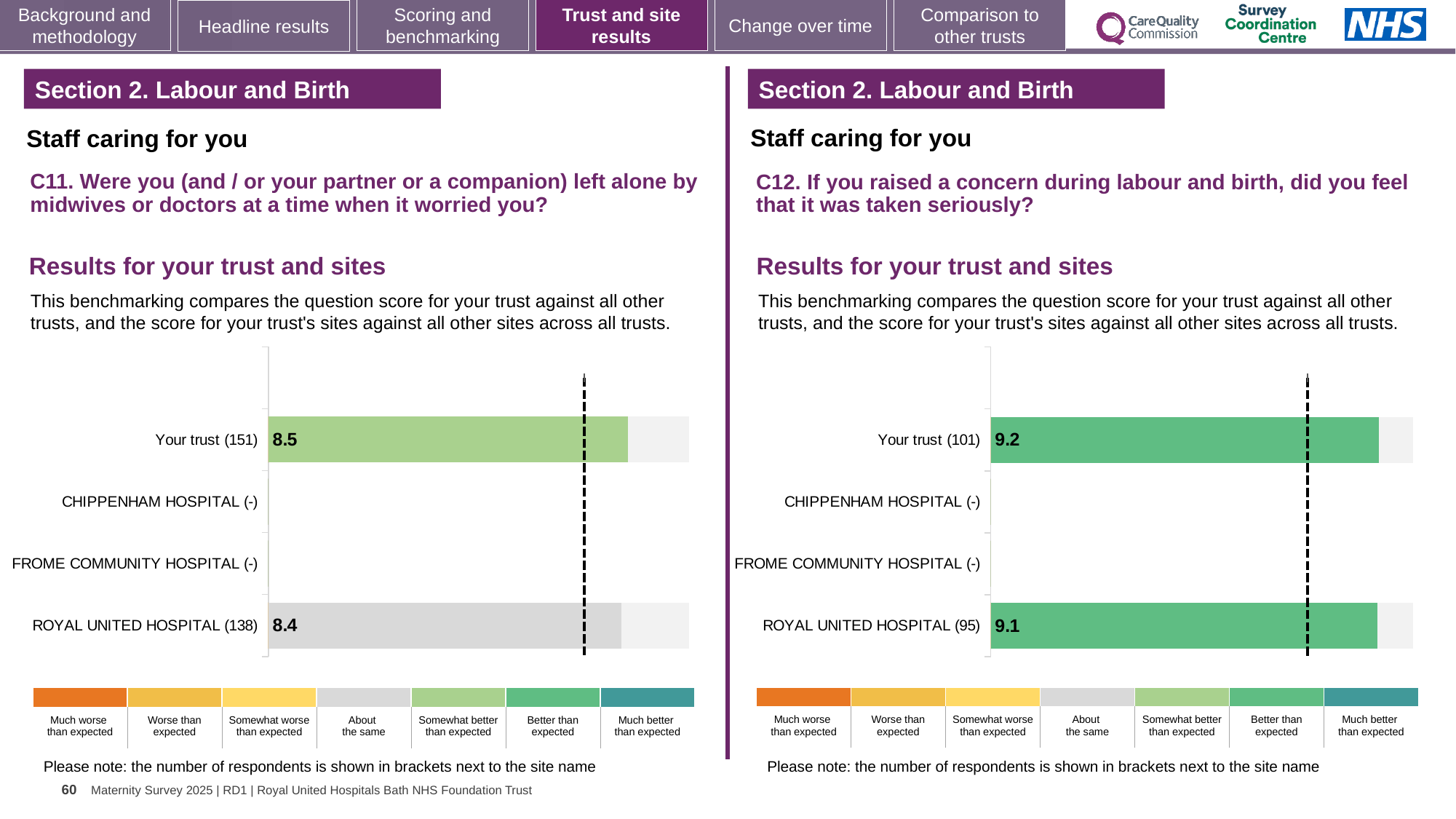
On the C11 chart (left), what is the score for ROYAL UNITED HOSPITAL (138)? 8.4 How many site/trust categories are listed on the C11 chart (left)? 4 On the C11 chart (left), what is the score for Your trust (151)? 8.5 On the C12 chart (right), what is the difference between the score for Your trust and the score for ROYAL UNITED HOSPITAL? 0.1 On the C11 chart (left), how many respondents are shown in brackets for ROYAL UNITED HOSPITAL? 138 What kind of chart is used on the C12 chart (right)? Bar chart On the C12 chart (right), which has the higher score, Your trust or ROYAL UNITED HOSPITAL? Your trust On the C11 chart (left), what is the difference between the score for Your trust and the score for ROYAL UNITED HOSPITAL? 0.1 On the C11 chart (left), which benchmark category does the colour of the ROYAL UNITED HOSPITAL bar correspond to in the legend? About the same On the C12 chart (right), what is the score for ROYAL UNITED HOSPITAL (95)? 9.1 On the C12 chart (right), which benchmark category does the colour of the Your trust bar correspond to in the legend? Better than expected On the C12 chart (right), what is the score for Your trust (101)? 9.2